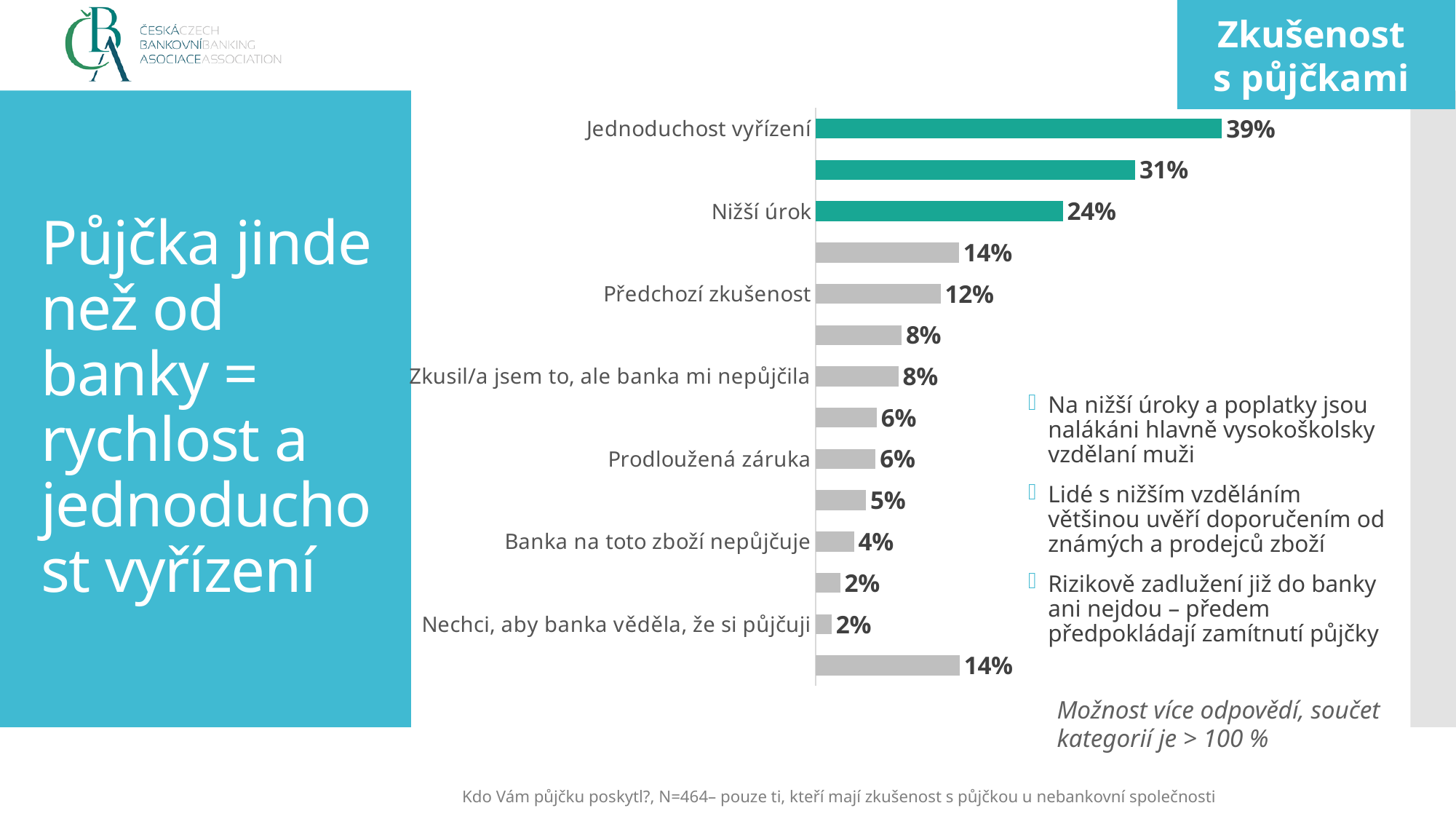
What value is shown for "Nechci, aby banka věděla, že si půjčuji"? 2% What percentage is shown for "Předchozí zkušenost"? 12% What percentage is shown for "Jednoduchost vyřízení"? 39% Which is larger, the value for "Předchozí zkušenost" or for "Prodloužená záruka"? Předchozí zkušenost Which category has the highest value in the chart? Jednoduchost vyřízení What value does the bar for "Nižší úrok" show? 24% What percentage is shown for "Banka na toto zboží nepůjčuje"? 4% What is the lowest value shown in the chart? 2% What value is shown for "Zkusil/a jsem to, ale banka mi nepůjčila"? 8% What is the difference between the values for "Jednoduchost vyřízení" and "Nižší úrok"? 15% How many bars are plotted in the chart? 14 What type of chart is shown on the slide? Bar chart